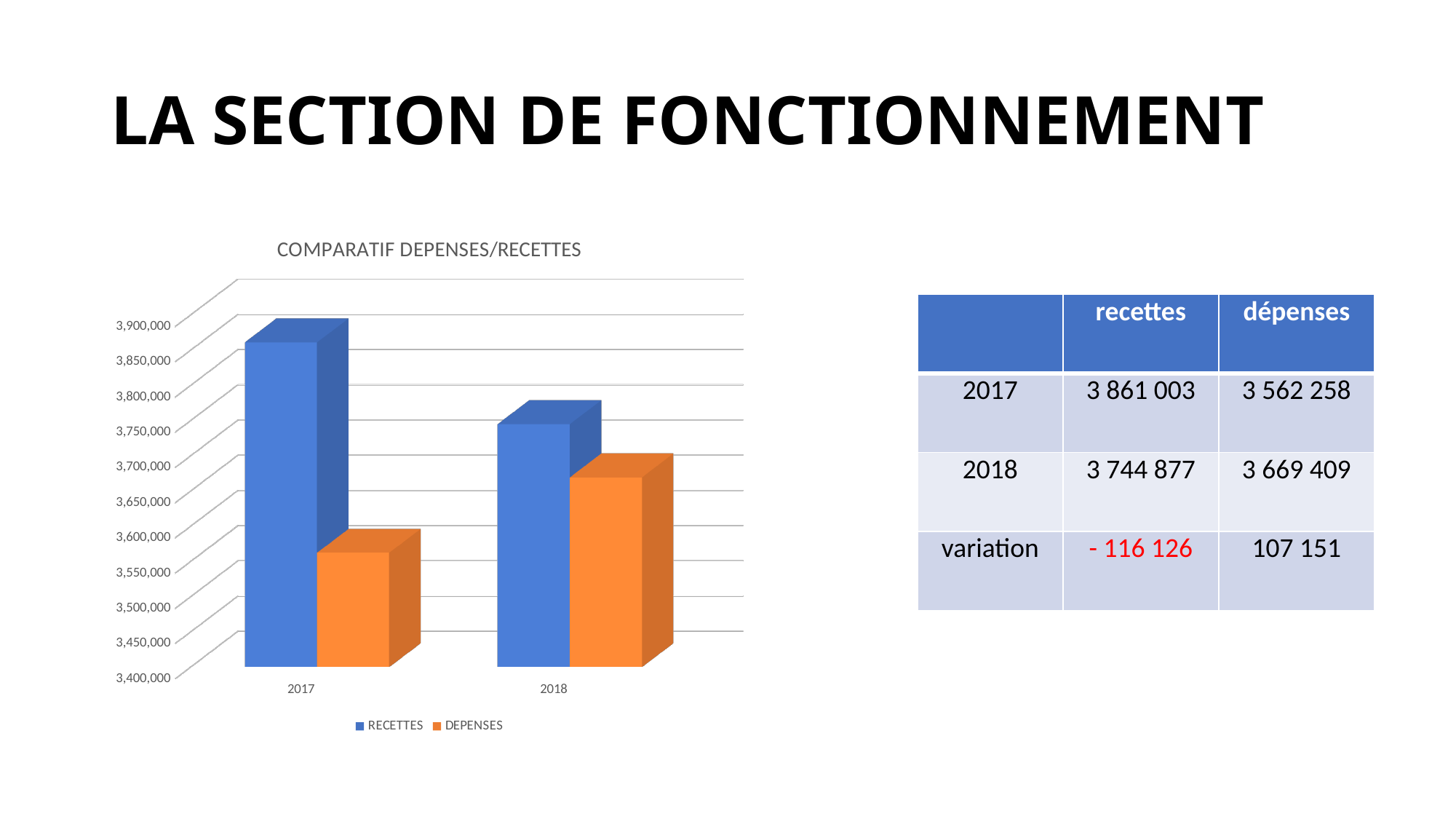
By how much did recettes decrease from 2017 to 2018, according to the table? 116 126 Do the RECETTES values rise or fall from 2017 to 2018? fall What is the title of the chart? COMPARATIF DEPENSES/RECETTES How many series does the legend of the chart list? 2 How many years are shown on the x axis of the chart? 2 Is the DEPENSES value for 2017 greater or less than 3,600,000? less What kind of chart is shown on the slide? bar chart Which year has the higher RECETTES bar in the chart? 2017 According to the table, what is the value of recettes for 2017? 3 861 003 Do the DEPENSES values rise or fall from 2017 to 2018? rise In 2017, which is larger in the chart, RECETTES or DEPENSES? RECETTES According to the table, what is the value of dépenses for 2018? 3 669 409